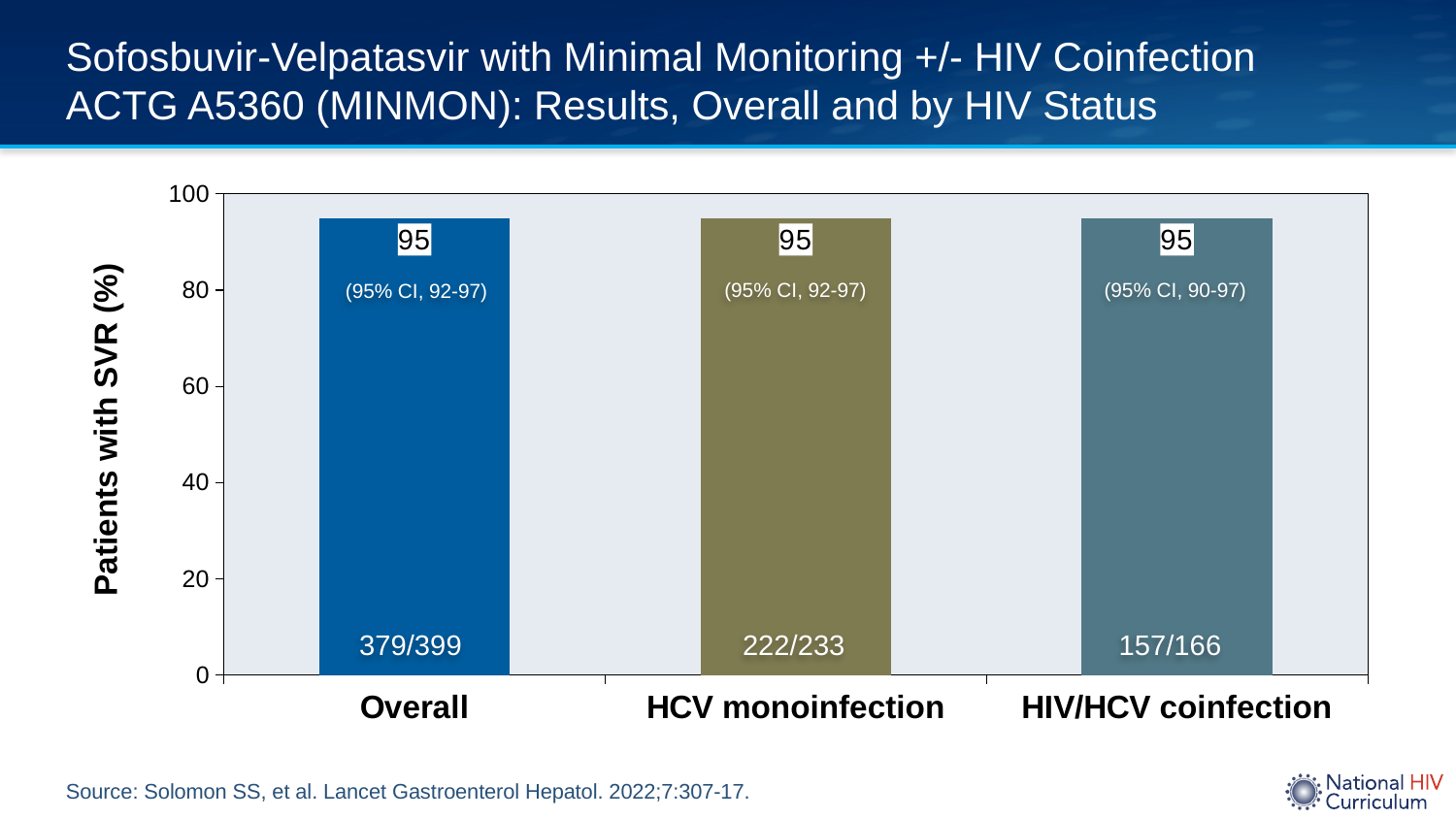
What fraction of patients is shown at the bottom of the Overall bar? 379/399 How many categories are shown on the x axis? 3 What fraction of patients is shown at the bottom of the HCV monoinfection bar? 222/233 What is the 95% CI shown for HIV/HCV coinfection? 90-97 What is the value for HIV/HCV coinfection? 95 What fraction of patients is shown at the bottom of the HIV/HCV coinfection bar? 157/166 What is the difference between the values for Overall and HIV/HCV coinfection? 0 What is the value for HCV monoinfection? 95 What is the value for Overall? 95 What is the label of the y axis? Patients with SVR (%) What kind of chart is this? bar chart Is the value for HCV monoinfection greater or less than 80? greater